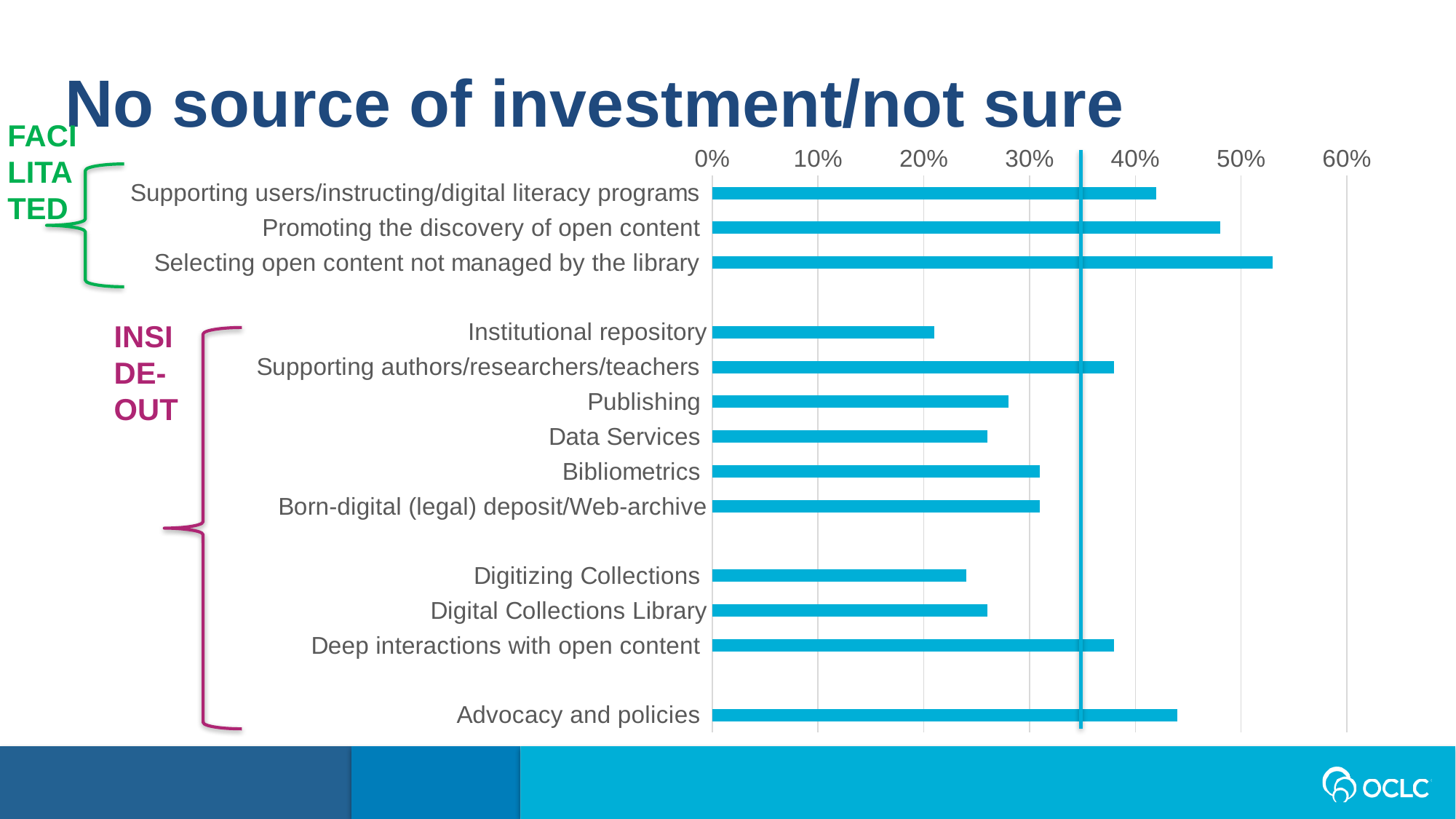
Which is larger: the value for Deep interactions with open content or the value for Digitizing Collections? Deep interactions with open content Is the value for Selecting open content not managed by the library greater or less than 50%? greater Is the value for Advocacy and policies greater or less than 40%? greater Is the value for Publishing greater or less than 30%? less Which category has the lowest value? Institutional repository What kind of chart is shown on the slide? bar chart Which category has the highest value? Selecting open content not managed by the library Which is larger: the value for Promoting the discovery of open content or the value for Supporting users/instructing/digital literacy programs? Promoting the discovery of open content How many categories (bars) are plotted in the chart? 13 What is the title of the chart? No source of investment/not sure